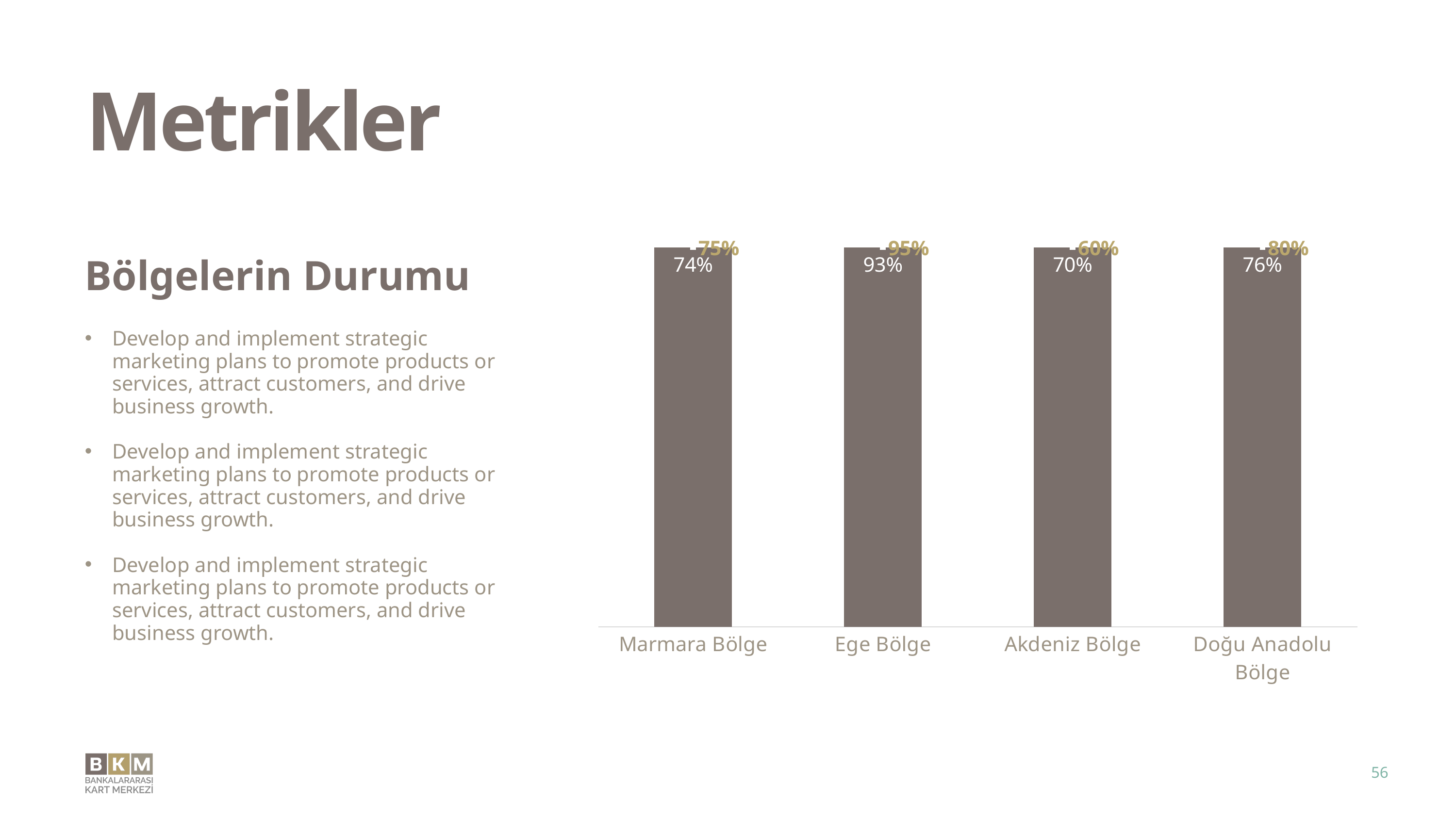
Which category has the lowest white data label value? Akdeniz Bölge Which category has the highest white data label value? Ege Bölge What type of chart is shown on the slide? bar chart What is the gold data label value shown above the Ege Bölge bar? 95% What is the gold data label value shown above the Akdeniz Bölge bar? 60% What is the white data label value for Doğu Anadolu Bölge? 76% What is the white data label value for Akdeniz Bölge? 70% How many categories are shown on the x axis of the chart? 4 What is the title of the chart section on the slide? Bölgelerin Durumu What is the white data label value for Marmara Bölge? 74% What is the white data label value for Ege Bölge? 93% What is the difference between the white data label values for Ege Bölge and Marmara Bölge? 19%